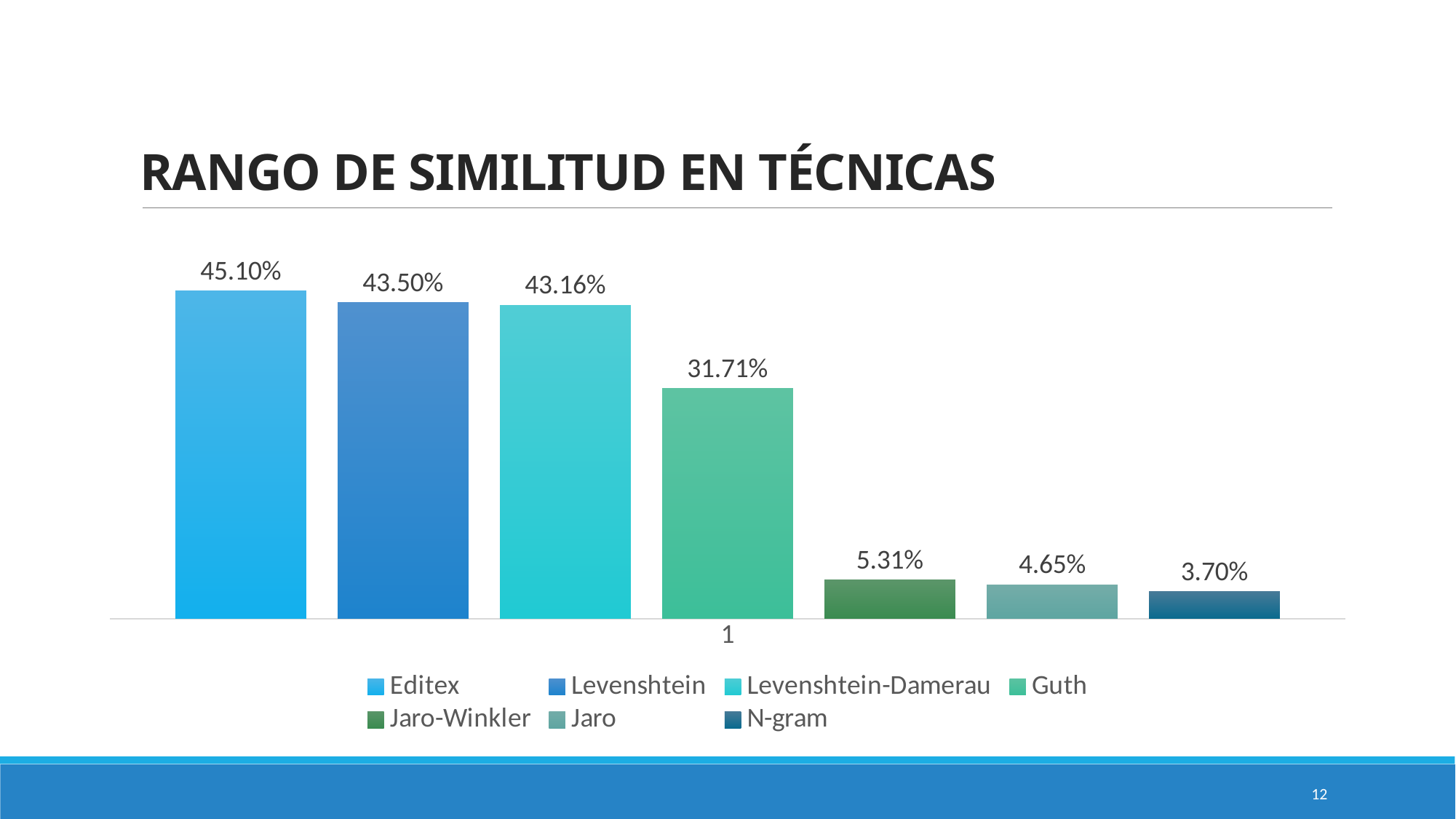
Which is larger, the value for Levenshtein-Damerau or the value for Guth? Levenshtein-Damerau What is the value for Guth? 31.71% Which technique has the highest value? Editex What is the value for Jaro-Winkler? 5.31% Which technique has the lowest value? N-gram What is the value for Editex? 45.10% What is the difference between the values for Editex and Guth? 13.39% What kind of chart is shown on the slide? Bar chart What is the value for N-gram? 3.70% What is the difference between the values for Jaro-Winkler and Jaro? 0.66% How many series does the legend list? 7 What is the title of the slide? RANGO DE SIMILITUD EN TÉCNICAS